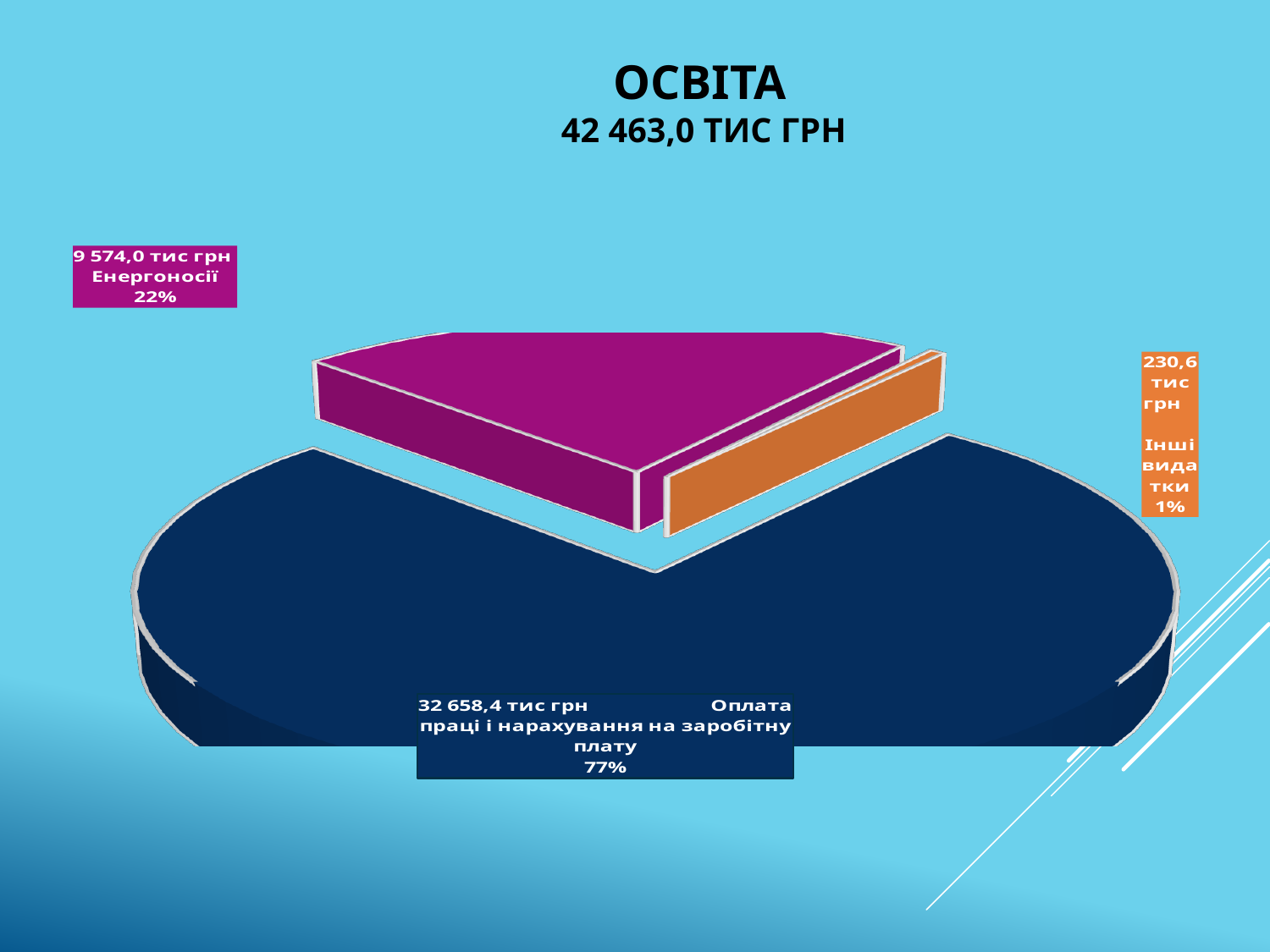
Which is larger, Енергоносії or Інші видатки? Енергоносії What share of the pie does Оплата праці і нарахування на заробітну плату represent? 77% What is the value for Інші видатки? 230,6 тис грн What kind of chart is shown on the slide? pie chart Which category has the largest slice? Оплата праці і нарахування на заробітну плату What total amount is shown under the chart title ОСВІТА? 42 463,0 тис грн What share of the pie does Енергоносії represent? 22% Which category has the smallest slice? Інші видатки What is the value for Оплата праці і нарахування на заробітну плату? 32 658,4 тис грн What is the value for Енергоносії? 9 574,0 тис грн What share of the pie does Інші видатки represent? 1% How many slices does the pie chart have? 3